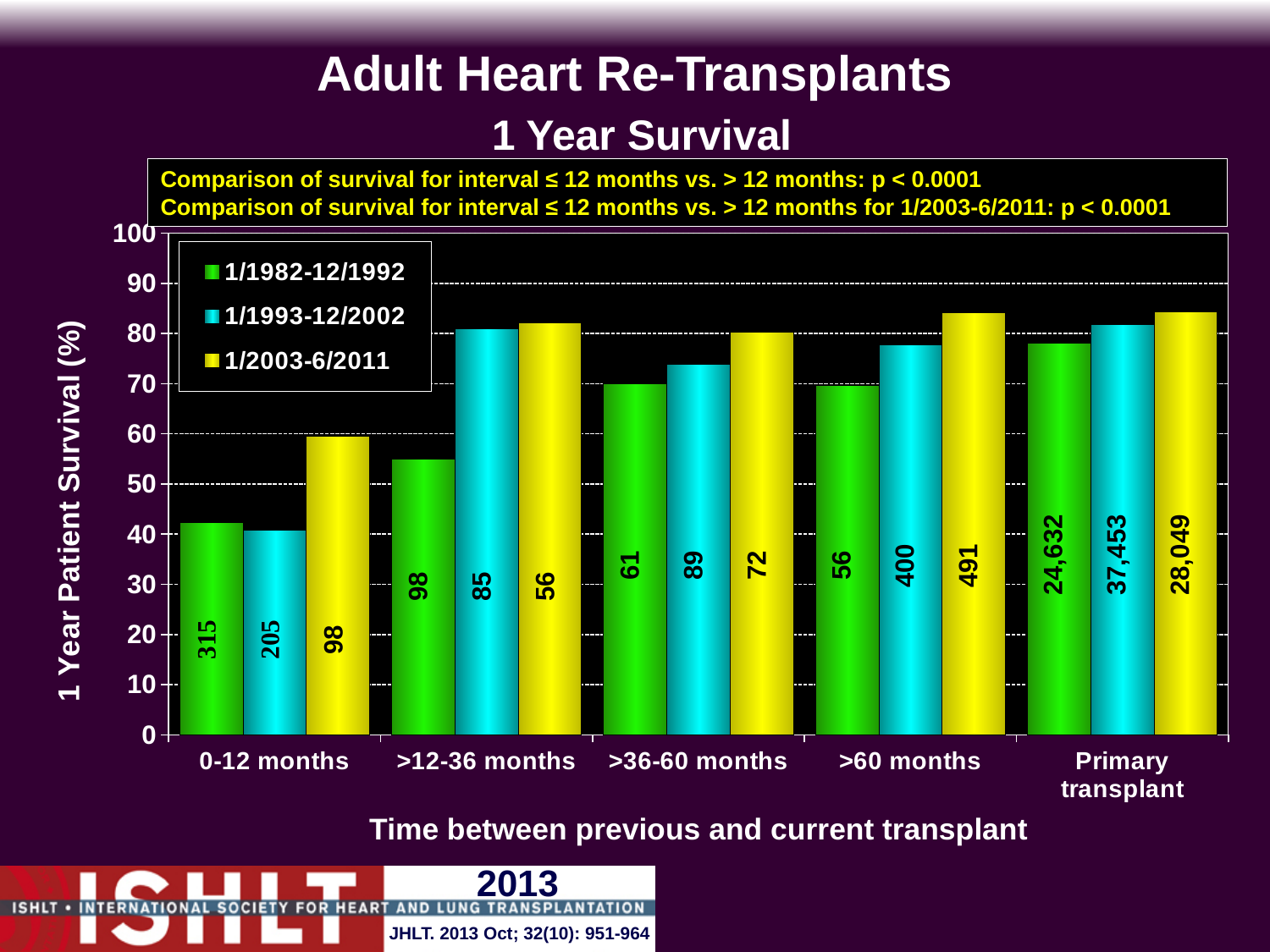
How many categories are shown along the x axis? 5 What number is printed inside the 1/1982-12/1992 bar for the 0-12 months category? 315 What kind of chart is shown on the slide? bar chart Is the 1 year survival for 1/1982-12/1992 in the 0-12 months category greater or less than 50? less Is the 1 year survival for 1/2003-6/2011 in the >60 months category greater or less than 80? greater What number is printed inside the 1/2003-6/2011 bar for the >60 months category? 491 Which is larger: the 1/1982-12/1992 survival for >12-36 months or for >36-60 months? >36-60 months What number is printed inside the 1/1993-12/2002 bar for the Primary transplant category? 37,453 Is the 1 year survival for 1/1982-12/1992 in the >12-36 months category greater or less than 50? greater Within the 0-12 months category, which series has the highest 1 year survival? 1/2003-6/2011 How many series does the legend list? 3 What is the label on the y axis of the chart? 1 Year Patient Survival (%)